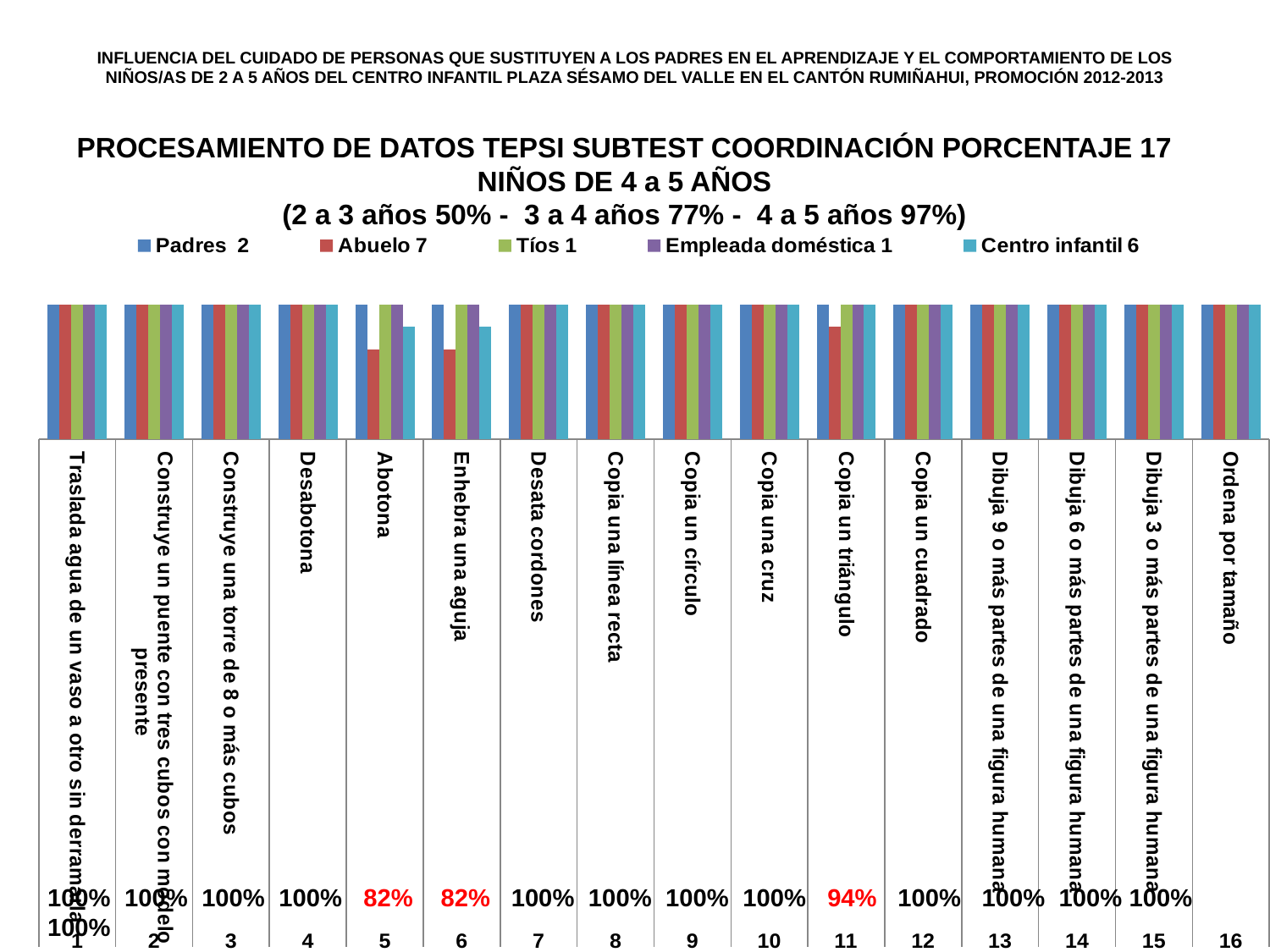
For the category Abotona, which bar is taller: Abuelo 7 or Centro infantil 6? Centro infantil 6 For the category Copia un triángulo, which bar is taller: Abuelo 7 or Tíos 1? Tíos 1 How many series does the legend list? 5 How many categories are shown along the x axis? 16 What percentage is printed below the category Desabotona? 100% Which series has the lowest bar for the category Enhebra una aguja? Abuelo 7 Which legend entry is shown in red? Abuelo 7 Which series has the lowest bar for the category Abotona? Abuelo 7 What kind of chart is shown on the slide? bar chart Which series has the lowest bar for the category Copia un triángulo? Abuelo 7 What percentage is printed below the category Copia un triángulo? 94% What percentage is printed below the category Abotona? 82%